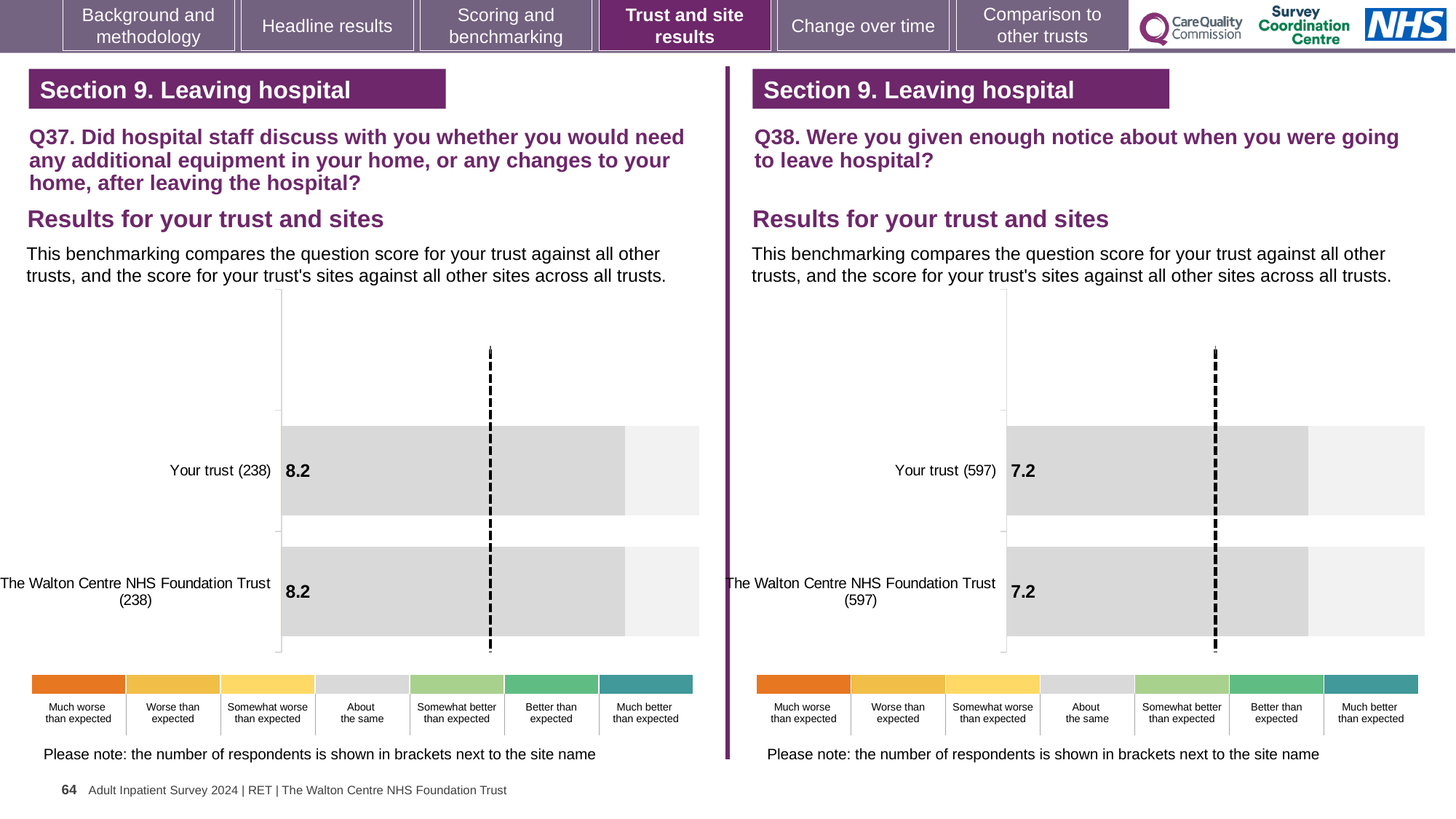
On the Q38 chart (right), what is the score for Your trust? 7.2 How many bars are plotted on the Q37 chart (left)? 2 On the Q37 chart (left), what is the score for The Walton Centre NHS Foundation Trust? 8.2 On the Q38 chart (right), how many respondents are shown in brackets next to The Walton Centre NHS Foundation Trust? 597 On the Q38 chart (right), what is the difference between the score for Your trust and the score for The Walton Centre NHS Foundation Trust? 0 Is the score for Your trust on the Q37 chart (left) larger or smaller than the score for Your trust on the Q38 chart (right)? Larger On the Q37 chart (left), how many respondents are shown in brackets next to Your trust? 238 How many bars are plotted on the Q38 chart (right)? 2 What kind of chart is used on the Q38 chart (right)? Bar chart On the Q37 chart (left), what is the difference between the score for Your trust and the score for The Walton Centre NHS Foundation Trust? 0 On the Q38 chart (right), what is the score for The Walton Centre NHS Foundation Trust? 7.2 On the Q37 chart (left), what is the score for Your trust? 8.2